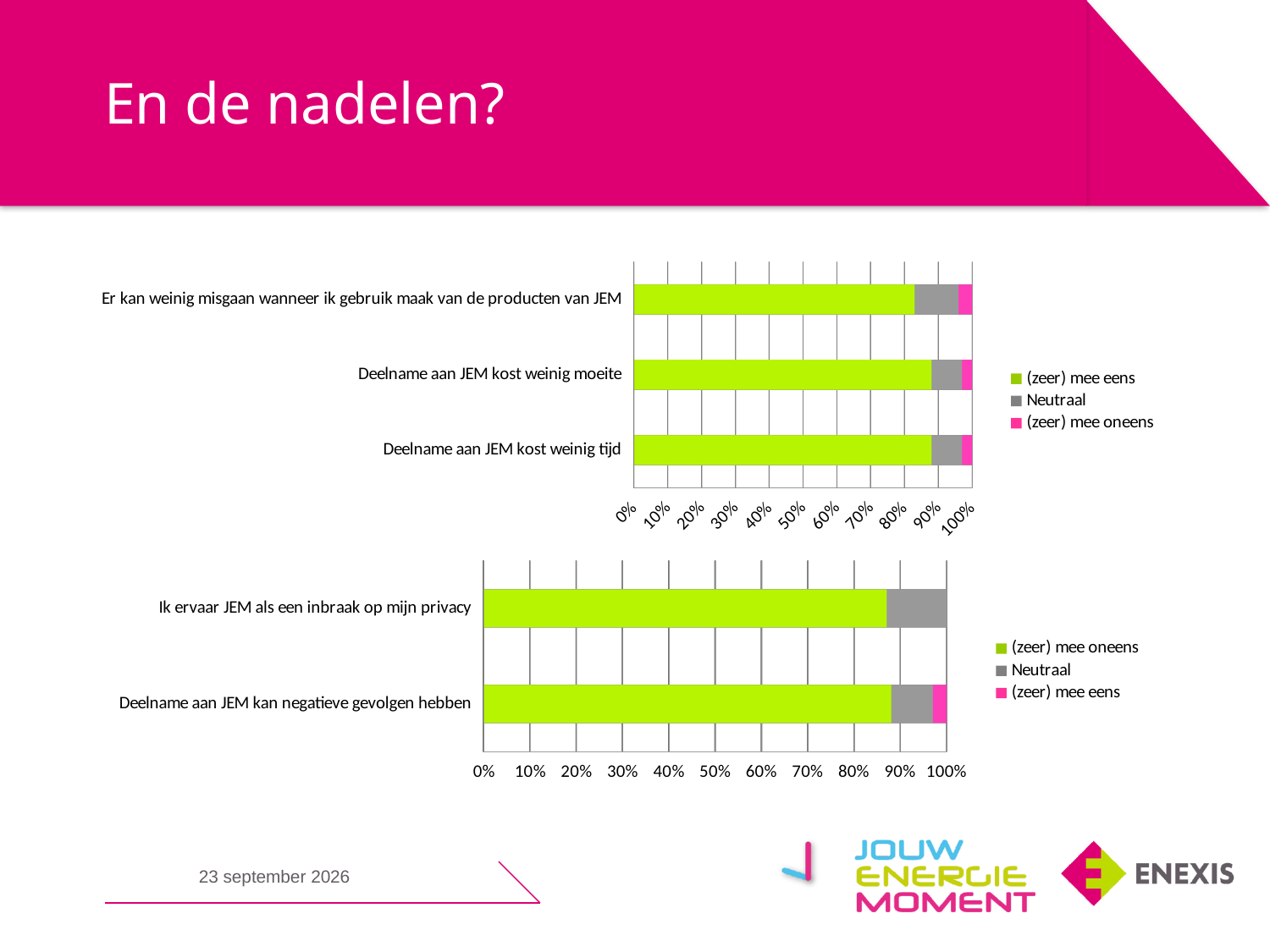
How many categories (statements) does the top chart show? 3 How many series does the legend of the top chart list? 3 How many categories (statements) does the bottom chart show? 2 In the top chart, is the '(zeer) mee eens' share for 'Deelname aan JEM kost weinig moeite' greater or less than 80%? greater What kind of chart is the top chart on the slide? Stacked bar chart In the top chart, is the '(zeer) mee eens' share for 'Er kan weinig misgaan wanneer ik gebruik maak van de producten van JEM' greater or less than 90%? less In the bottom chart, which statement has no '(zeer) mee eens' (pink) segment? Ik ervaar JEM als een inbraak op mijn privacy In the top chart, which statement has the smallest '(zeer) mee eens' share? Er kan weinig misgaan wanneer ik gebruik maak van de producten van JEM In the bottom chart, is the '(zeer) mee oneens' share for 'Ik ervaar JEM als een inbraak op mijn privacy' greater or less than 80%? greater In the bottom chart, which series is shown in green according to the legend? (zeer) mee oneens